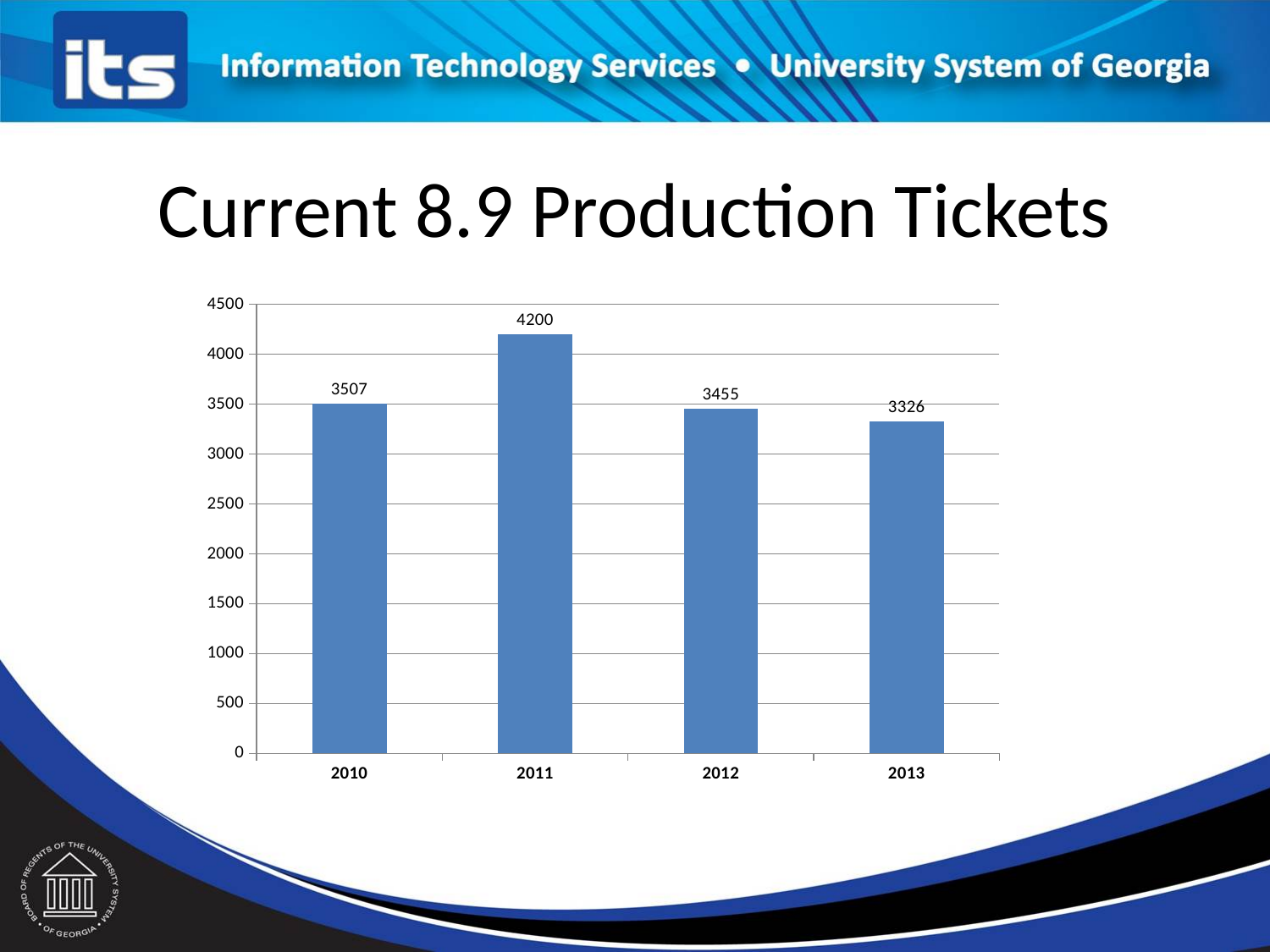
Which year has the highest value? 2011 What is the value for 2011? 4200 What is the value for 2010? 3507 Which year has the lowest value? 2013 What is the difference between the values for 2012 and 2013? 129 What kind of chart is shown on the slide? bar chart What is the value for 2013? 3326 What is the difference between the values for 2011 and 2010? 693 Which is larger, the value for 2010 or the value for 2012? 2010 How many years are shown on the x axis? 4 What is the value for 2012? 3455 Is the value for 2011 greater or less than 4000? greater